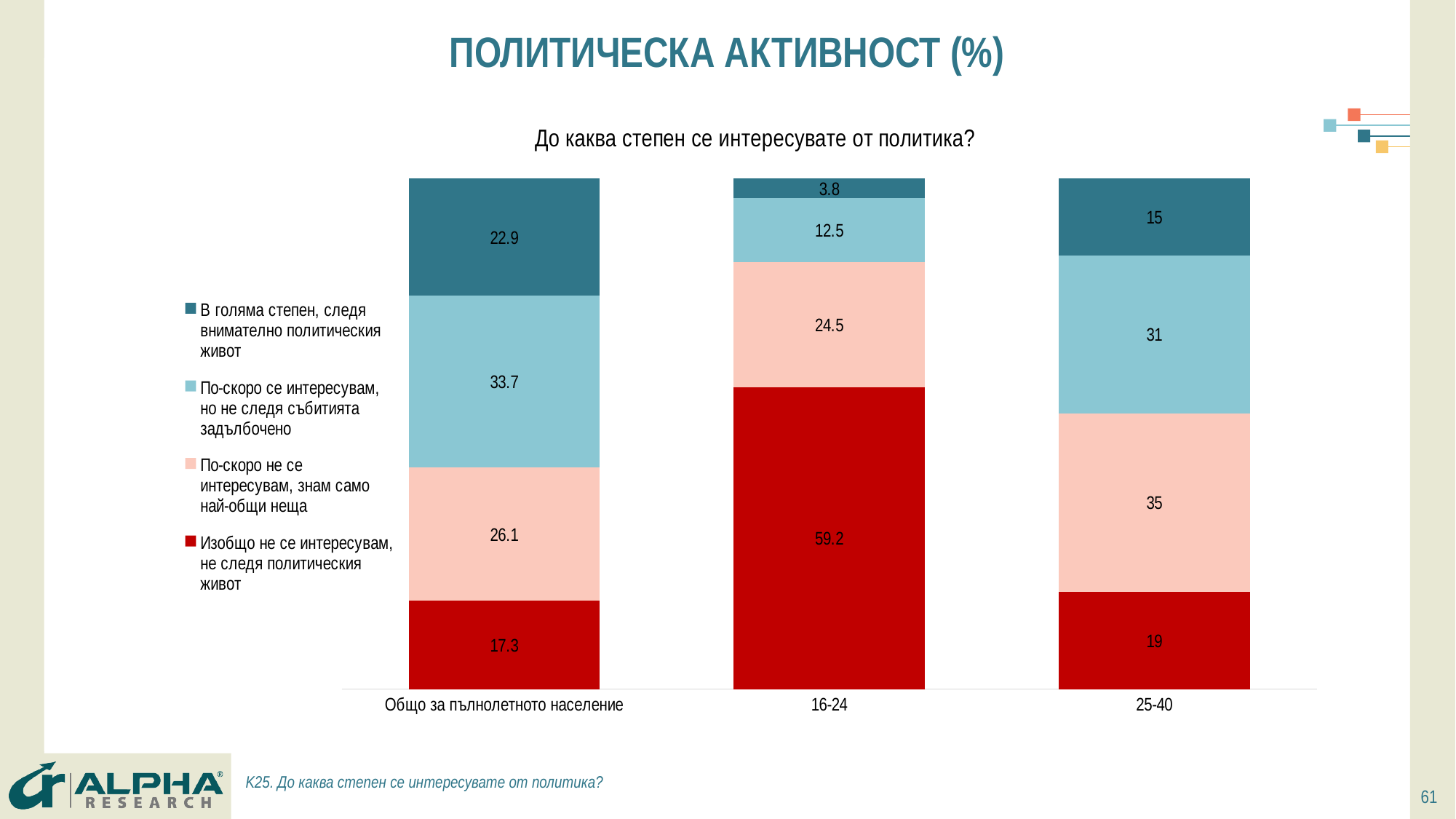
What is the difference between the "Изобщо не се интересувам, не следя политическия живот" values for 16-24 and "Общо за пълнолетното население"? 41.9 What is the total of the stacked bar for the 25-40 group? 100 Which category has the lowest value for "В голяма степен, следя внимателно политическия живот"? 16-24 What is the value for "В голяма степен, следя внимателно политическия живот" for "Общо за пълнолетното население"? 22.9 What is the value for "По-скоро се интересувам, но не следя събитията задълбочено" in the 25-40 group? 31 Which is larger: the "По-скоро не се интересувам, знам само най-общи неща" value for 25-40 or for 16-24? 25-40 How many series does the legend list? 4 Which category has the highest value for "Изобщо не се интересувам, не следя политическия живот"? 16-24 How many categories are shown on the x axis of the chart? 3 What type of chart is shown on the slide? Stacked bar chart What question is shown as the chart's subtitle? До каква степен се интересувате от политика? What is the value for "Изобщо не се интересувам, не следя политическия живот" in the 16-24 group? 59.2